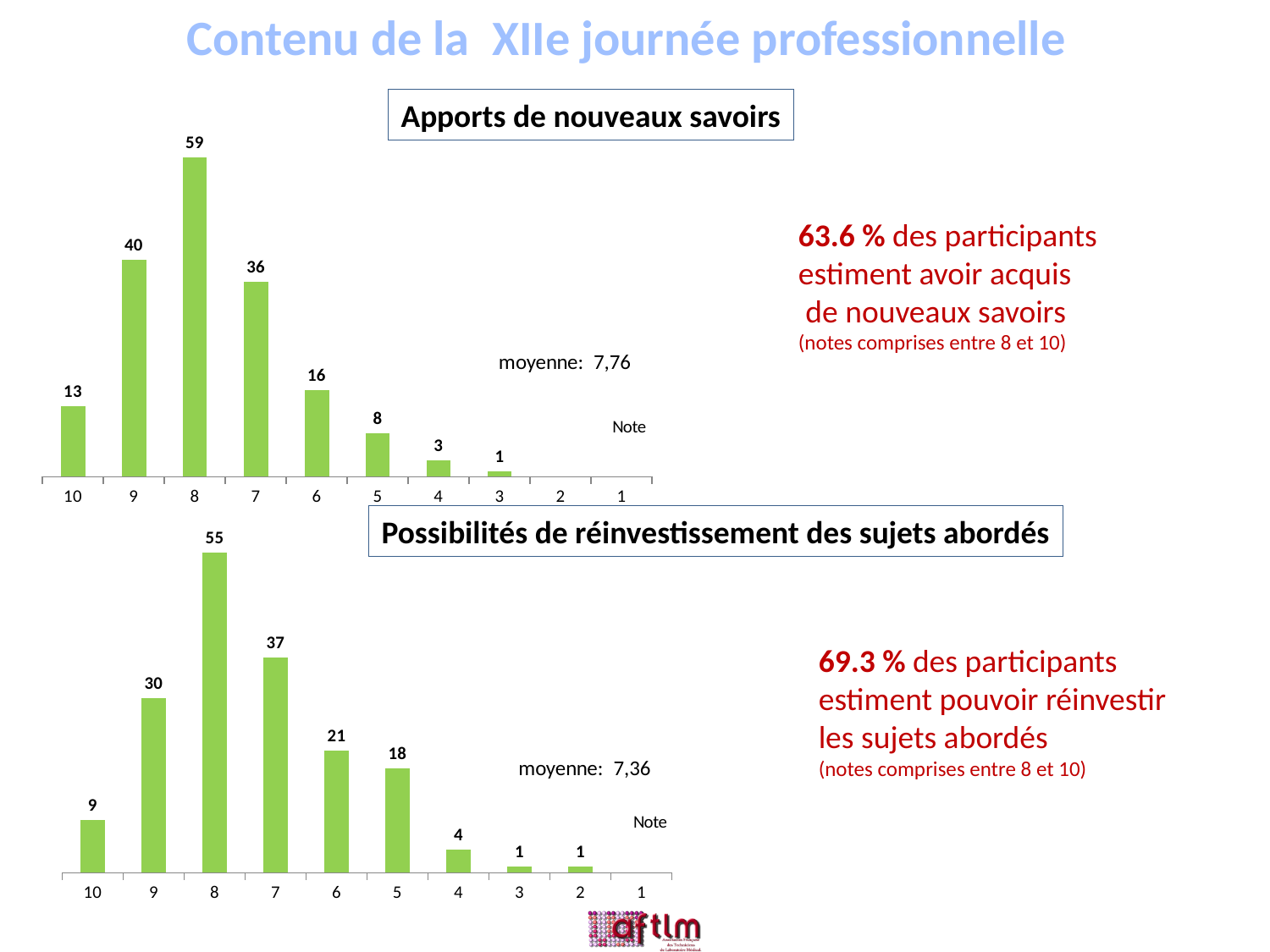
In the 'Apports de nouveaux savoirs' chart, what is the difference between the values for note 9 and note 7? 4 In the 'Apports de nouveaux savoirs' chart, what is the value for note 10? 13 In the 'Possibilités de réinvestissement des sujets abordés' chart, what is the value for note 6? 21 In the 'Possibilités de réinvestissement des sujets abordés' chart, what is the difference between the values for note 8 and note 7? 18 In the 'Possibilités de réinvestissement des sujets abordés' chart, which is larger, the value for note 9 or the value for note 7? note 7 What type of chart is the 'Apports de nouveaux savoirs' chart? bar chart In the 'Apports de nouveaux savoirs' chart, which note has the highest value? 8 In the 'Possibilités de réinvestissement des sujets abordés' chart, how many note categories are shown on the x axis? 10 In the 'Apports de nouveaux savoirs' chart, what is the mean (moyenne) shown? 7,76 In the 'Possibilités de réinvestissement des sujets abordés' chart, what is the mean (moyenne) shown? 7,36 In the 'Apports de nouveaux savoirs' chart, what is the value for note 8? 59 In the 'Possibilités de réinvestissement des sujets abordés' chart, what is the value for note 8? 55